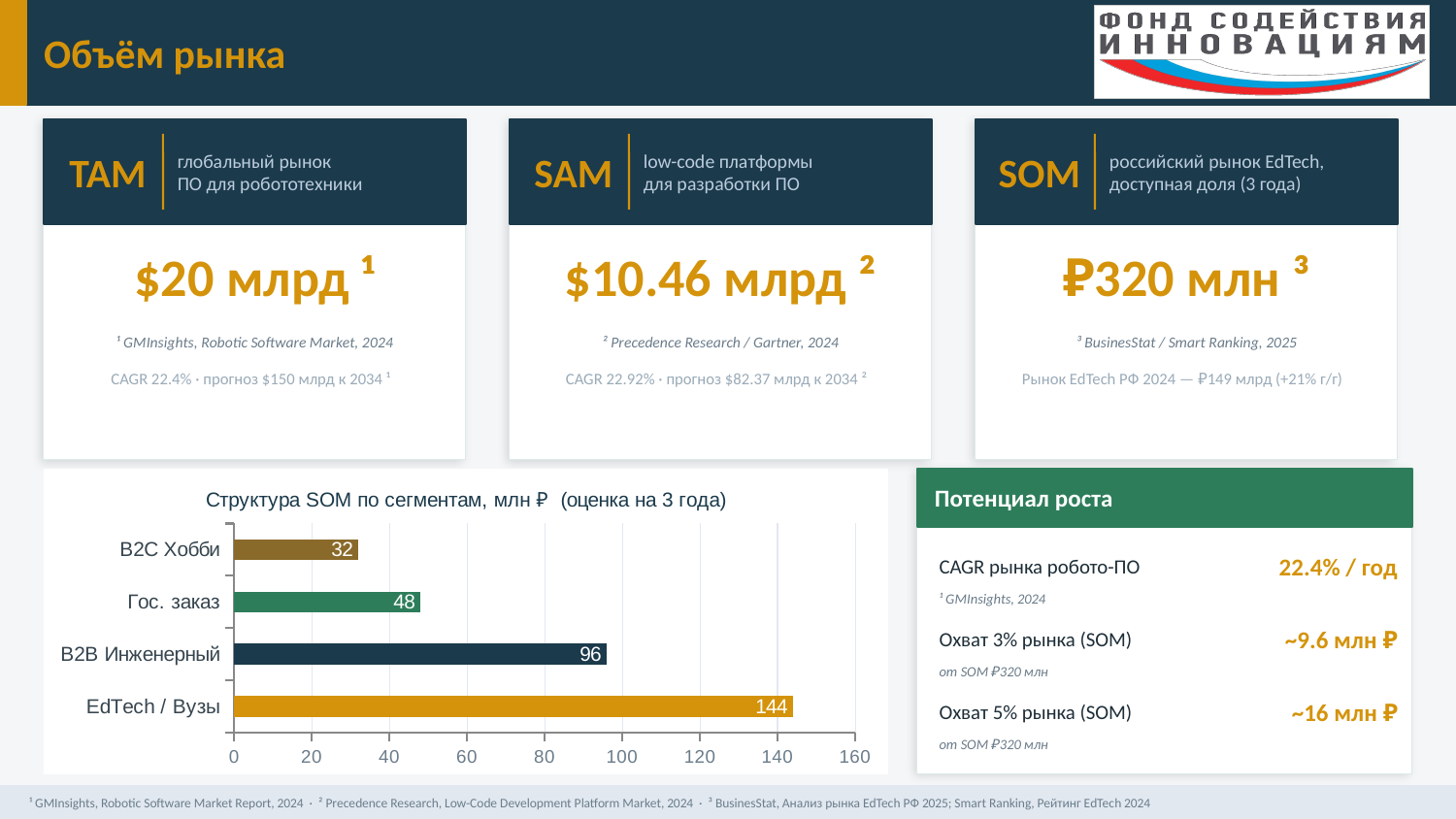
What is the value for B2C Хобби in the chart? 32 Which segment has the lowest value in the chart? B2C Хобби What is the difference between the values for Гос. заказ and B2C Хобби? 16 What is the value for B2B Инженерный in the chart? 96 What is the value for Гос. заказ in the chart? 48 What is the value for EdTech / Вузы in the chart? 144 Which segment has the highest value in the chart? EdTech / Вузы How many segments are shown in the chart? 4 What is the difference between the values for EdTech / Вузы and B2B Инженерный? 48 Which is larger, the value for B2B Инженерный or the value for Гос. заказ? B2B Инженерный What is the title of the chart? Структура SOM по сегментам, млн ₽ (оценка на 3 года) What kind of chart is shown on the slide? bar chart